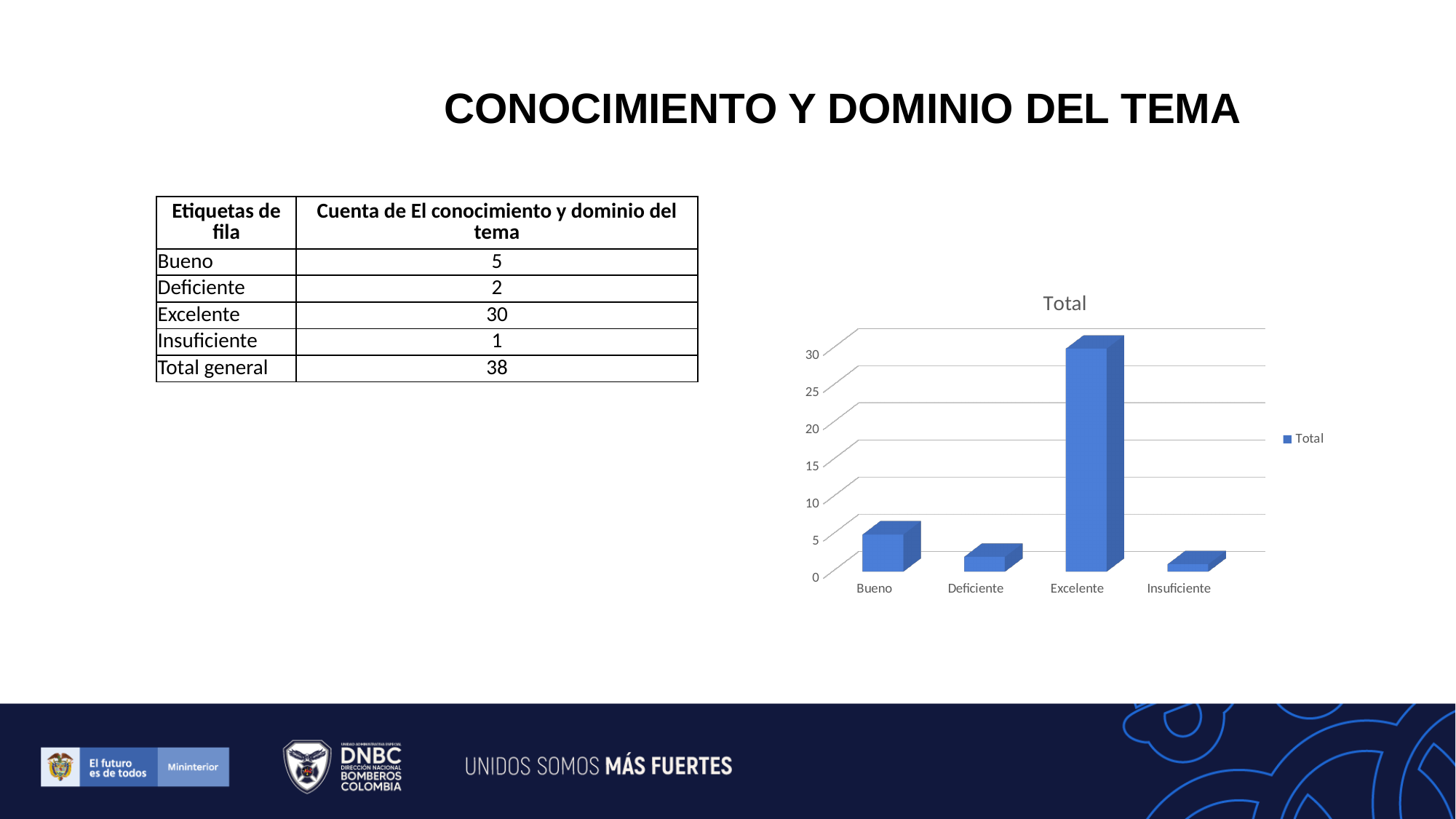
How many categories are shown on the x axis of the chart? 4 How many series does the chart legend list? 1 Is the value for Bueno greater or less than 10? less What is the title of the chart? Total Is the value for Excelente greater or less than 25? greater According to the table on the slide, what is the count for Deficiente? 2 Which category has the lowest bar in the chart? Insuficiente According to the table on the slide, what is the count for Excelente? 30 According to the table on the slide, what is the difference between the counts for Excelente and Bueno? 25 Which category has the highest bar in the chart? Excelente Which is larger, the value for Bueno or the value for Deficiente? Bueno What kind of chart is shown on the slide? bar chart